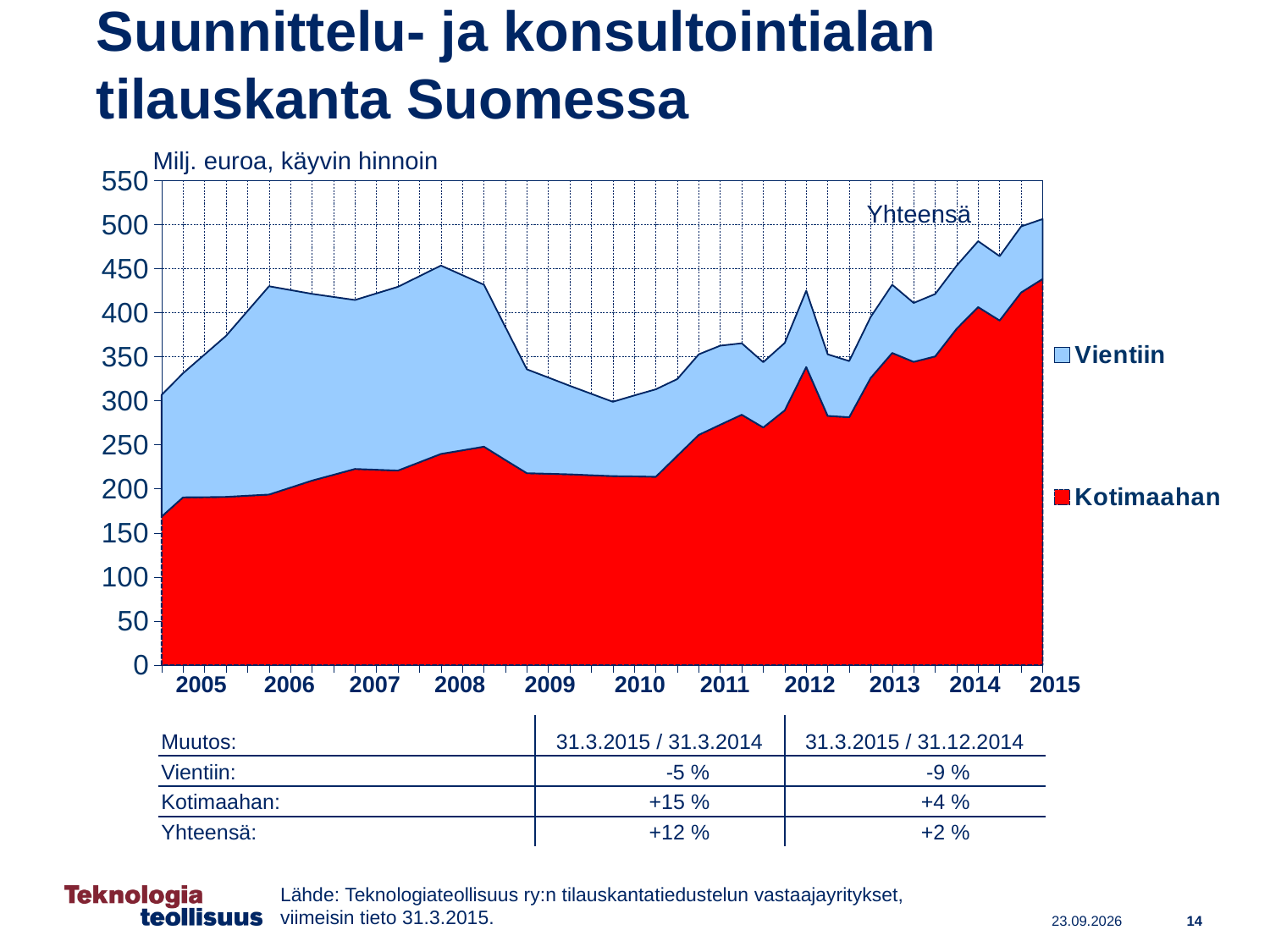
Does the Kotimaahan series rise or fall between 2010 and 2015? rise How many year labels are shown on the x axis? 11 What kind of chart is shown on the slide? area chart Is the Kotimaahan value at the start of 2005 greater or less than 200? less Is the Kotimaahan value at the start of 2010 greater or less than 250? less Is the Kotimaahan value at the end of the series in 2015 greater or less than 400? greater Does the total (Yhteensä) fall or rise between 2008 and 2010? fall What unit is stated above the chart's y axis? Milj. euroa, käyvin hinnoin Which series is shown in red in the chart? Kotimaahan How many series does the chart legend list? 2 According to the table below the chart, what is the change for Vientiin between 31.3.2014 and 31.3.2015? -5 %